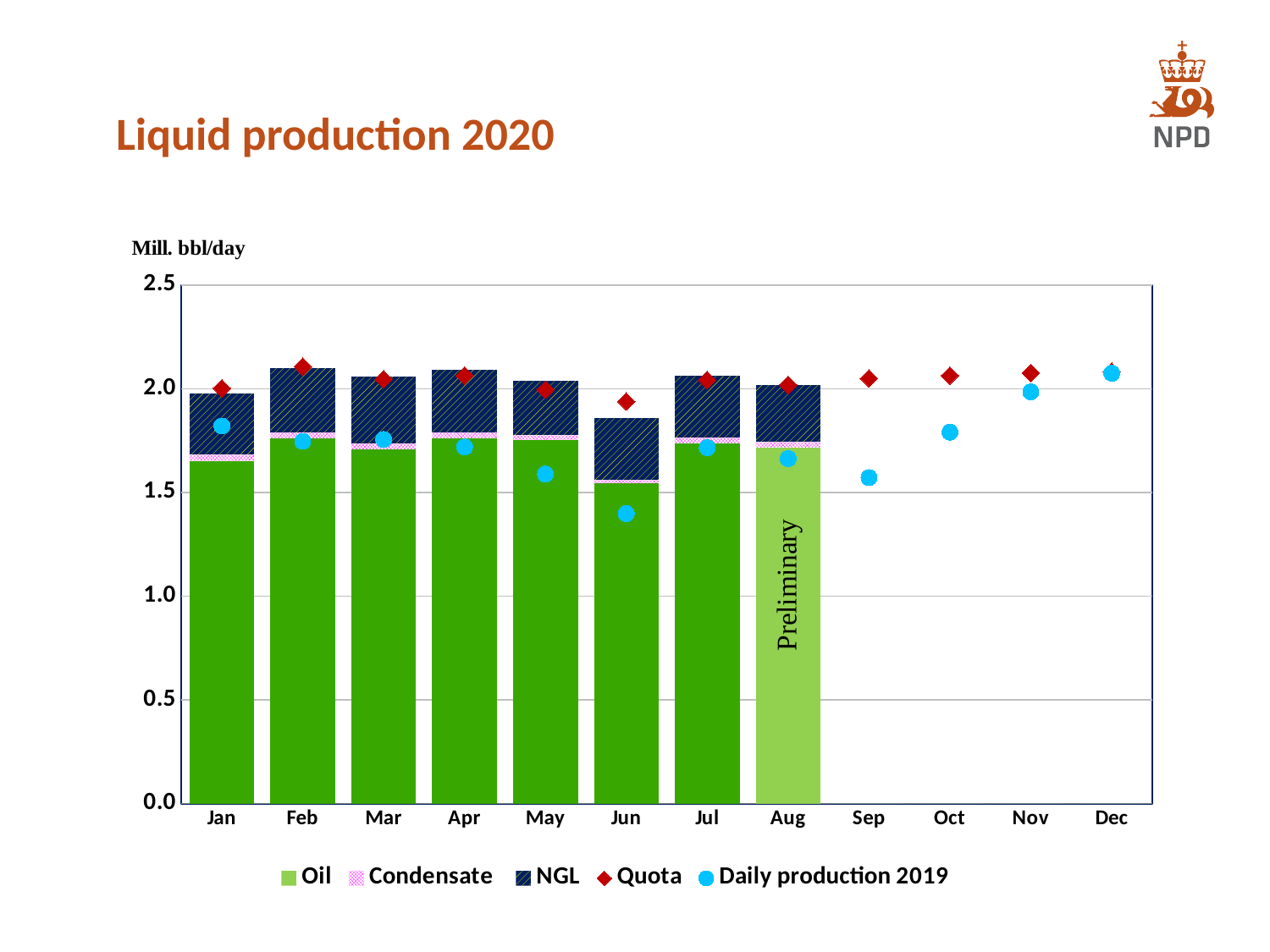
Is the total production bar for Feb greater or less than 2.0? greater Which month's bar is labelled 'Preliminary'? Aug Is the total production bar for Jun greater or less than 2.0? less Which month has the lowest total production bar? Jun Which month has the lowest Daily production 2019 value? Jun What kind of chart is shown on the slide? combination bar and line chart Is the Daily production 2019 value for Sep greater or less than 2.0? less Which month has the highest Daily production 2019 value? Dec Do the Daily production 2019 values rise or fall from Sep to Dec? rise How many months are shown on the x axis? 12 For how many months are production bars plotted? 8 How many series does the legend list? 5